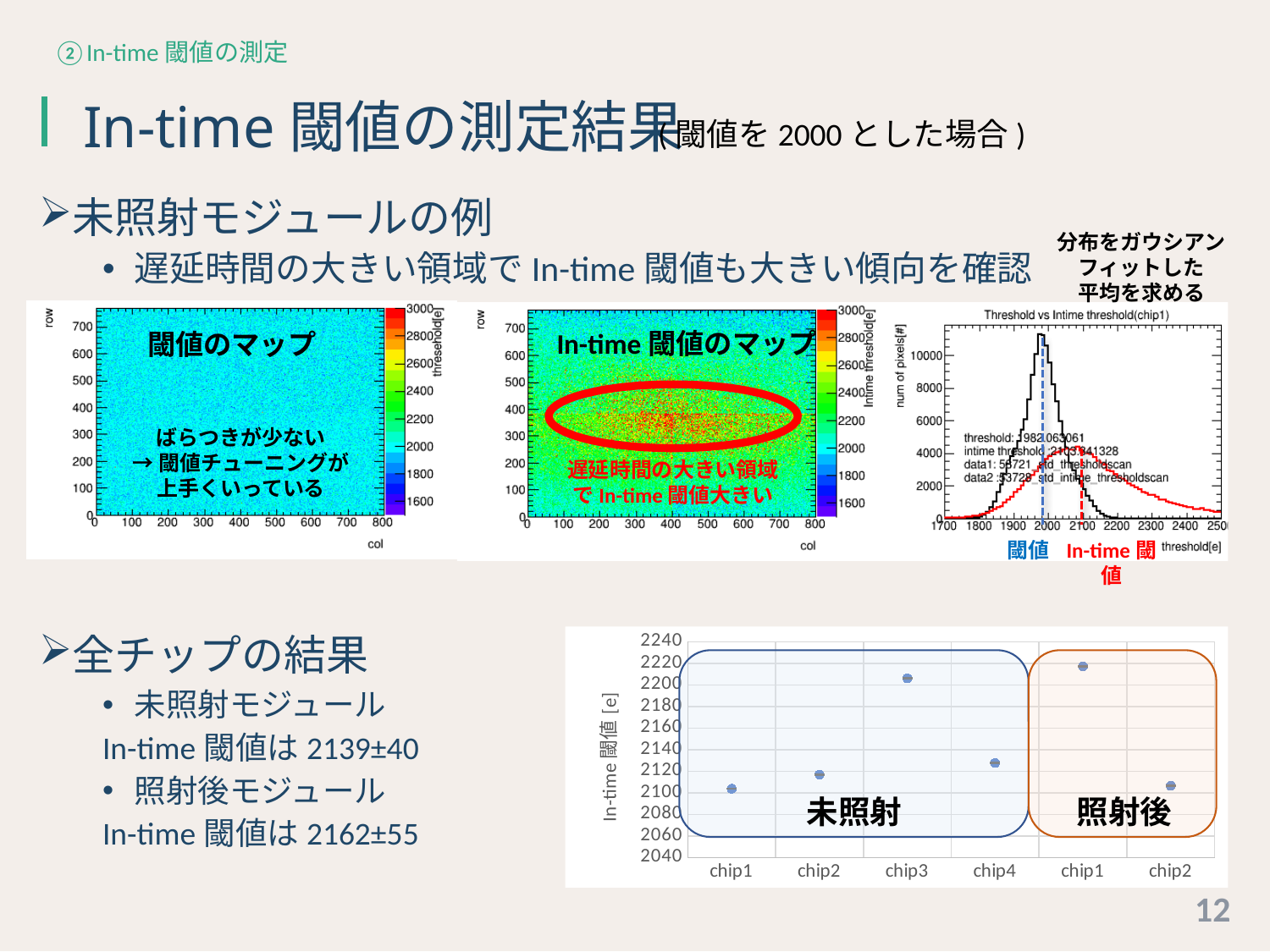
In the bottom-right chart, is the value for chip3 in the 未照射 group greater or less than 2180? greater In the bottom-right chart, is the value for chip1 in the 照射後 group greater or less than 2200? greater What is the title of the histogram chart on the right of the middle row? Threshold vs Intime threshold(chip1) In the bottom-right chart, which has the larger In-time 閾値: chip4 or chip1 in the 未照射 group? chip4 In the bottom-right chart, which has the larger In-time 閾値: chip3 or chip2 in the 未照射 group? chip3 In the bottom-right chart, is the value for chip2 in the 照射後 group greater or less than 2120? less How many data points are plotted in the bottom-right chart? 6 What is the y-axis label of the bottom-right chart? In-time 閾値 [e] In the bottom-right chart, which has the larger In-time 閾値: chip1 or chip2 in the 照射後 group? chip1 What kind of chart is the bottom-right chart? scatter chart